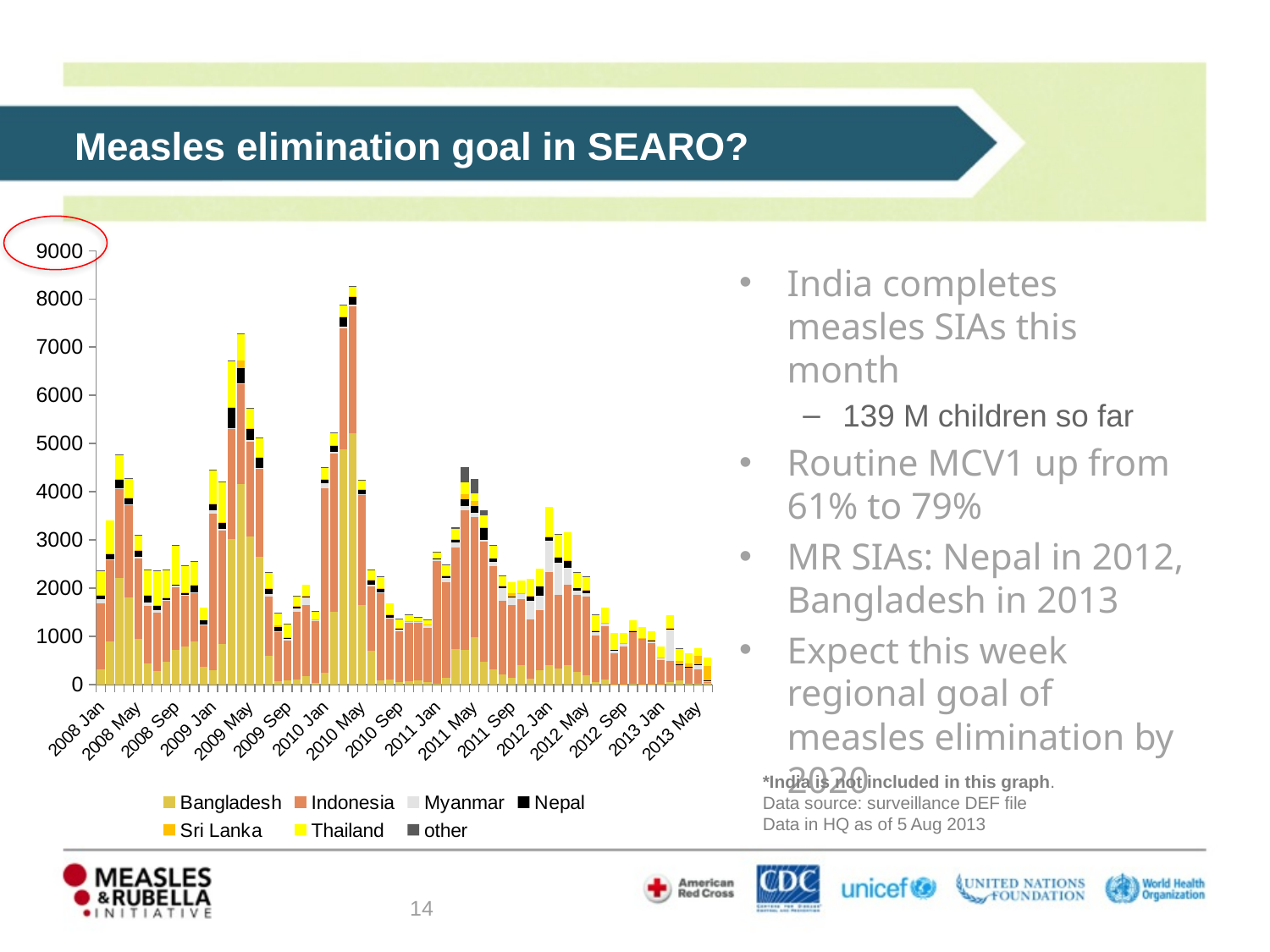
Which has a larger total bar, 2008 Jan or 2013 Jan? 2008 Jan Do the bar totals generally rise or fall from 2012 Jan to 2013 May? fall Is the total of the tallest bar on the chart greater or less than 7000? greater In which year does the tallest stacked bar on the chart occur? 2010 Is the total for 2013 May greater or less than 1000? less Is the total for 2008 Jan greater or less than 3000? less What is the highest value shown on the chart's y axis? 9000 Which countries or groups are listed in the chart legend? Bangladesh, Indonesia, Myanmar, Nepal, Sri Lanka, Thailand, other Which has a larger total bar, 2009 May or 2011 May? 2009 May How many series does the chart legend list? 7 What kind of chart is shown on the slide? stacked bar chart